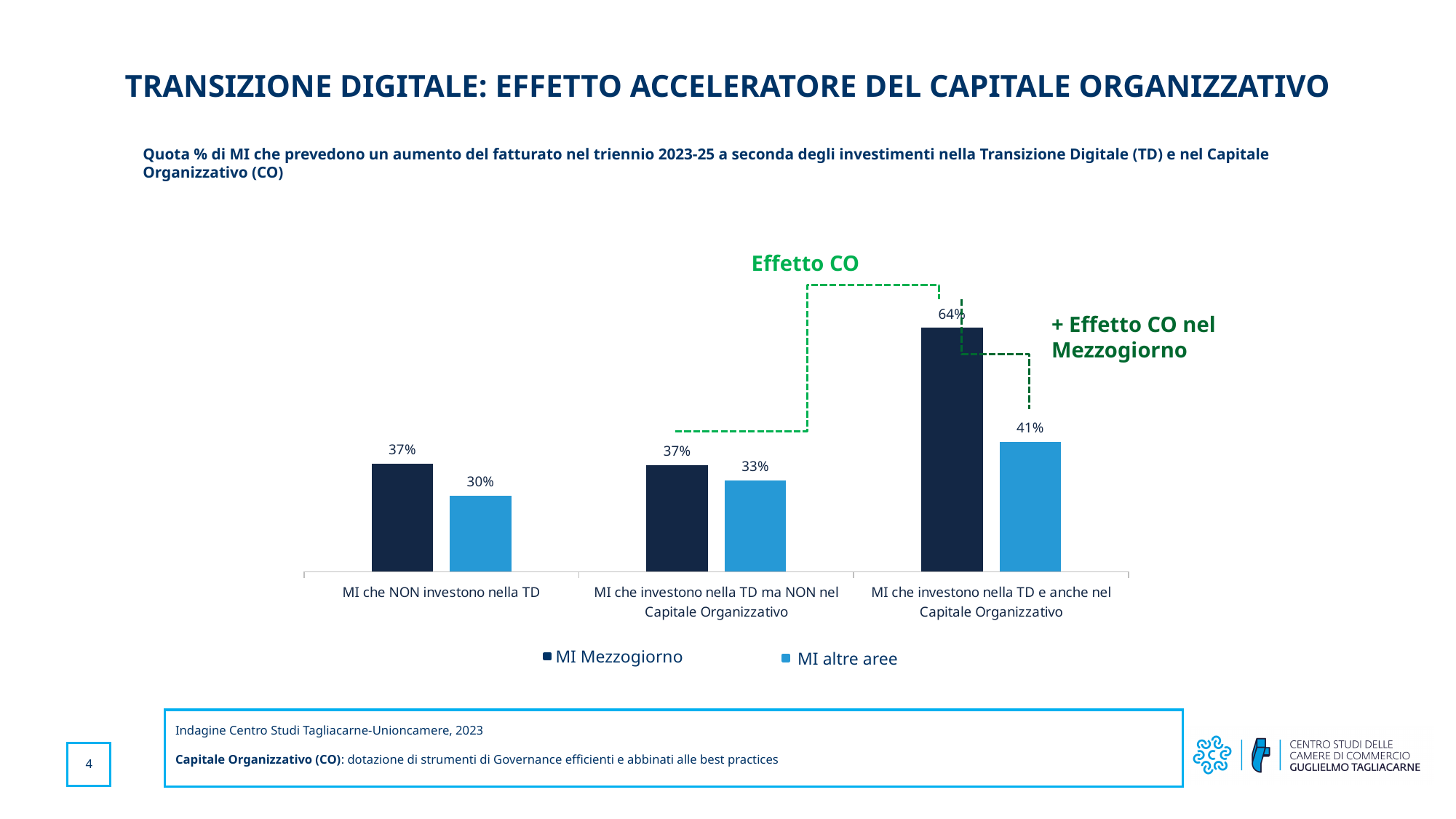
How many categories are shown on the x axis? 3 What kind of chart is shown on the slide? Bar chart Do the values for MI altre aree rise or fall across the categories from left to right? Rise Which is larger in the category 'MI che NON investono nella TD': MI Mezzogiorno or MI altre aree? MI Mezzogiorno Which category has the highest value for MI Mezzogiorno? MI che investono nella TD e anche nel Capitale Organizzativo What is the value for MI altre aree in the category 'MI che investono nella TD ma NON nel Capitale Organizzativo'? 33% What are the two series listed in the legend? MI Mezzogiorno and MI altre aree Which category has the lowest value for MI altre aree? MI che NON investono nella TD What is the value for MI Mezzogiorno in the category 'MI che investono nella TD e anche nel Capitale Organizzativo'? 64% How many series does the legend list? 2 What is the value for MI altre aree in the category 'MI che NON investono nella TD'? 30% What is the difference between MI Mezzogiorno and MI altre aree in the category 'MI che investono nella TD e anche nel Capitale Organizzativo'? 23 percentage points